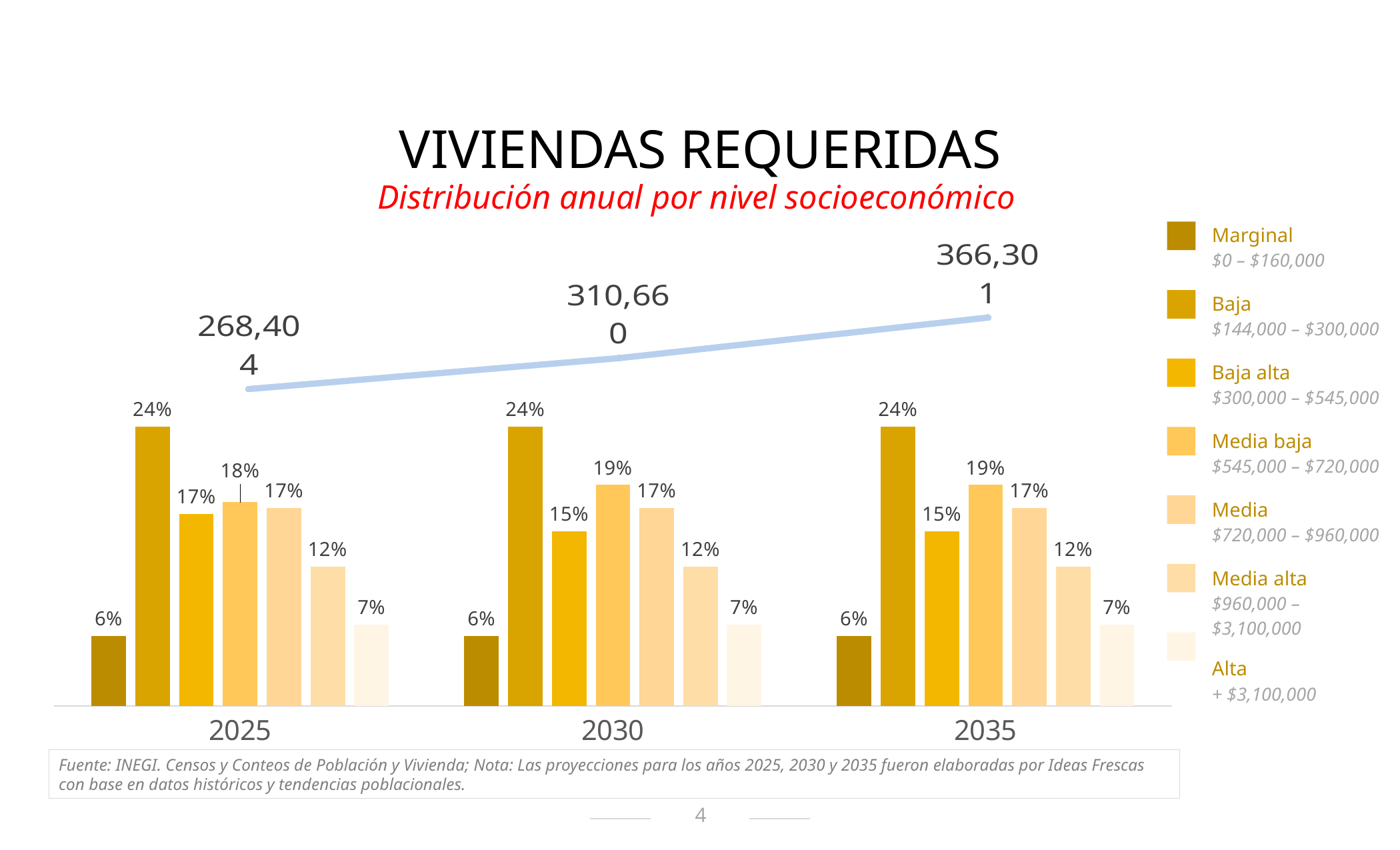
What kind of chart is shown on the slide? Bar chart with a line What is the difference between the Media baja value in 2030 and in 2025? 1 percentage point Which socioeconomic level has the highest share in 2025? Baja What is the value for Media baja in 2030? 19% In 2035, which is larger: Media alta or Alta? Media alta Does the total line rise or fall from 2025 to 2035? Rise What is the value for Baja in 2025? 24% How many year groups are shown on the x axis? 3 How many series does the legend list? 7 Which socioeconomic level has the lowest share in 2030? Marginal What is the value for Baja alta in 2035? 15% What total value is shown on the line for 2030? 310,660